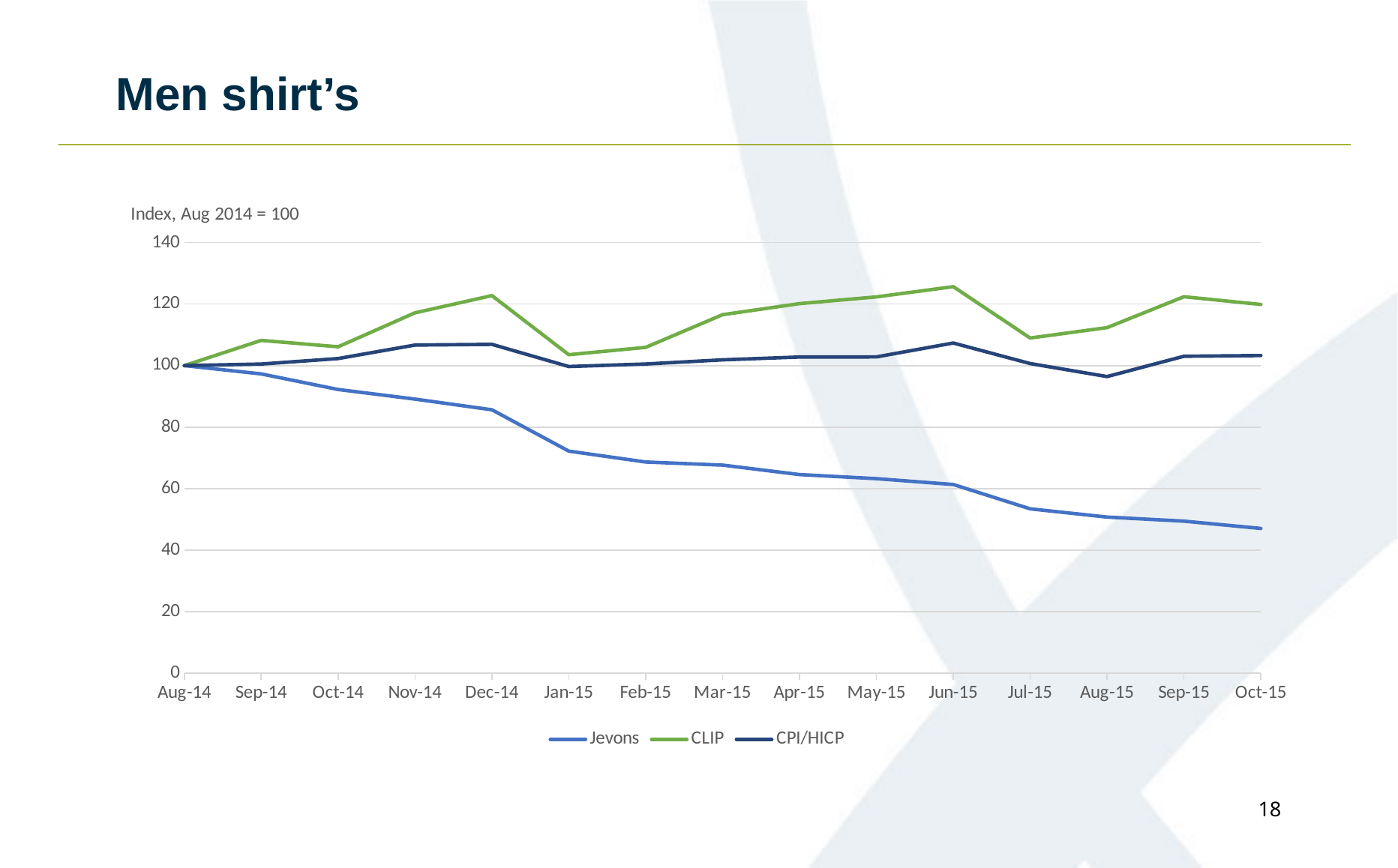
Is the value for Jevons in Oct-15 greater or less than 60? less How many months are plotted along the x axis? 15 In Oct-15, which is larger, the CLIP value or the Jevons value? CLIP How many series does the legend list? 3 What colour is the Jevons line in the legend? blue What kind of chart is shown on the slide? line chart Is the value for CPI/HICP in Aug-15 greater or less than 100? less Does the Jevons series rise or fall from Aug-14 to Oct-15? fall What is the index value of the Jevons series in Aug-14? 100 Is the value for CLIP in Nov-14 greater or less than 100? greater In which month does the Jevons series reach its lowest value? Oct-15 Which series has the lowest value in Jun-15? Jevons